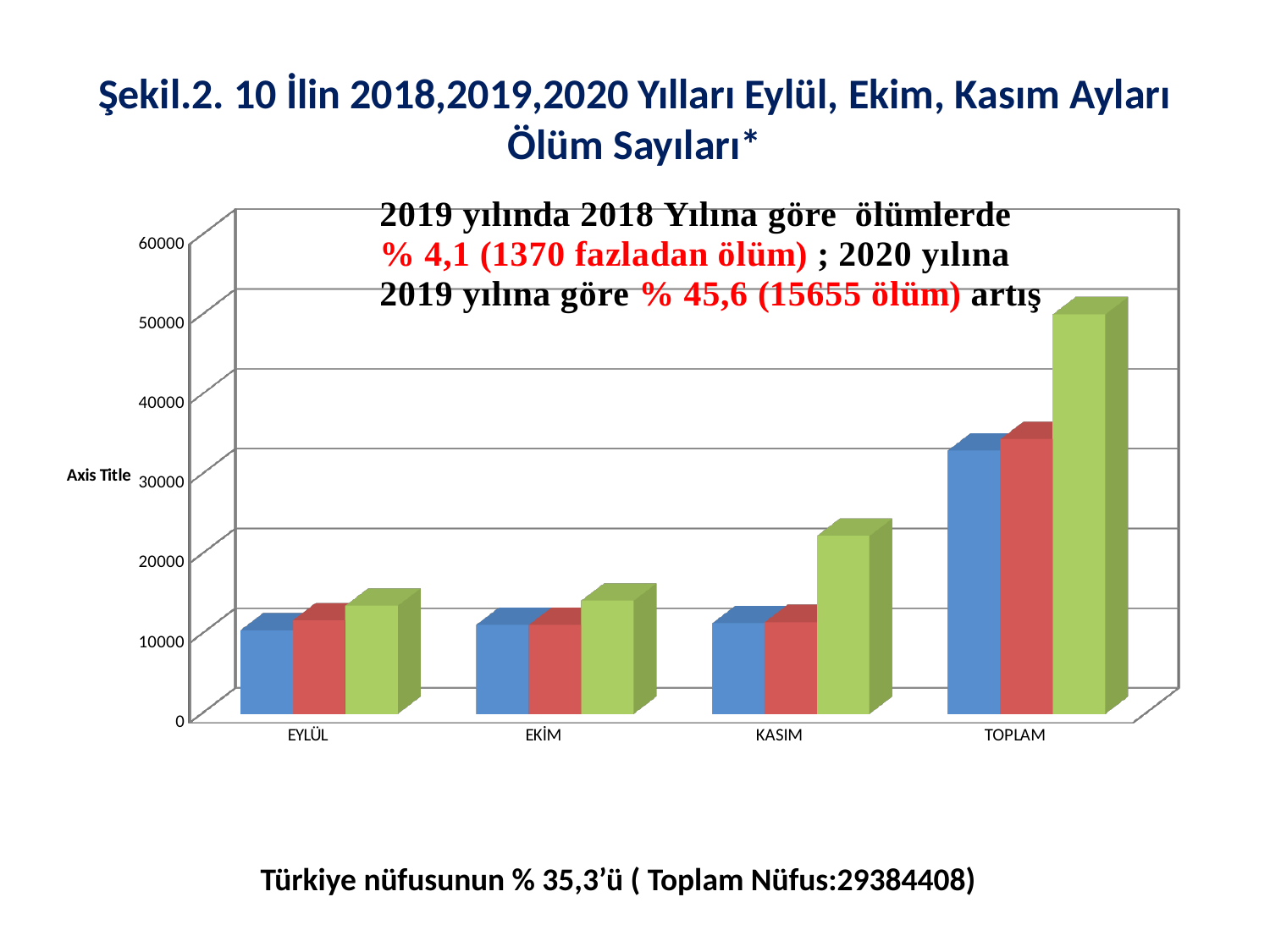
Do the green bars rise or fall from EYLÜL to KASIM? rise Is the value of the green bar for TOPLAM greater or less than 40000? greater Among the month categories (EYLÜL, EKİM, KASIM), which has the tallest green bar? KASIM In the TOPLAM category, which bar is larger, the blue bar or the green bar? the green bar How many bars are plotted for each category in the chart? 3 Which category has the tallest bars in the chart? TOPLAM Is the value of the green bar for KASIM greater or less than 20000? greater What kind of chart is shown on the slide? bar chart Is the value of the blue bar for TOPLAM greater or less than 30000? greater How many categories are shown on the x axis of the chart? 4 What is the title of the slide's chart figure? Şekil.2. 10 İlin 2018,2019,2020 Yılları Eylül, Ekim, Kasım Ayları Ölüm Sayıları*